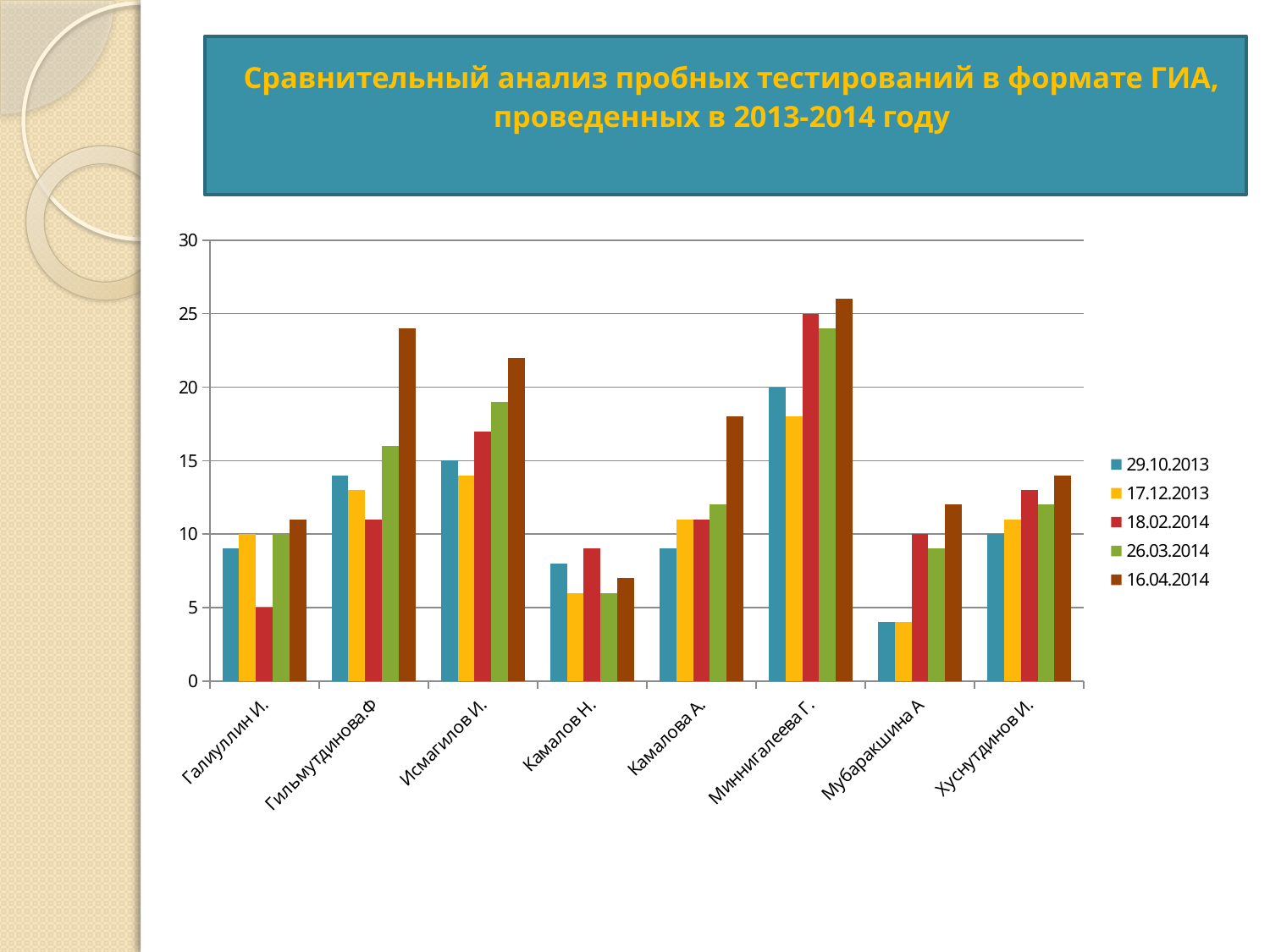
Which student has the highest value in the 16.04.2014 series? Миннигалеева Г. How many series does the legend list? 5 Which student has the lowest value in the 29.10.2013 series? Мубаракшина А Is the value for Гильмутдинова.Ф in the 16.04.2014 series greater or less than 20? greater What is the value for Миннигалеева Г. in the 18.02.2014 series? 25 Which date is the first entry in the legend? 29.10.2013 What is the value for Миннигалеева Г. in the 29.10.2013 series? 20 What kind of chart is shown on the slide? bar chart In the 16.04.2014 series, which is larger: the value for Камалова А. or the value for Хуснутдинов И.? Камалова А. Is the value for Камалов Н. in the 16.04.2014 series greater or less than 10? less What is the value for Исмагилов И. in the 29.10.2013 series? 15 How many students (categories) are shown on the x axis? 8